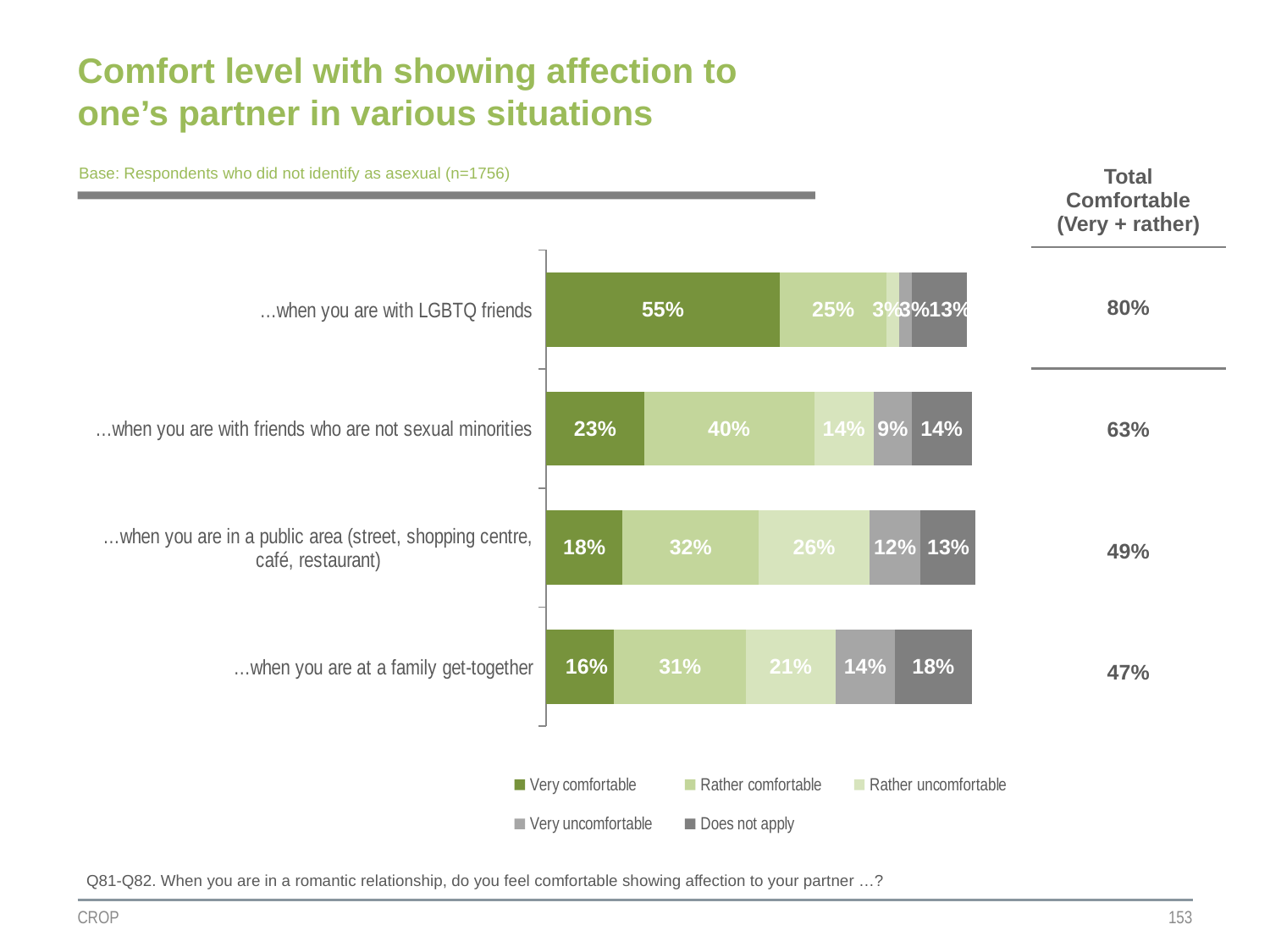
What percentage of respondents are rather uncomfortable showing affection when they are in a public area? 26% Which is larger: the 'Very uncomfortable' share at a family get-together or in a public area? At a family get-together What percentage of respondents answered 'Does not apply' for showing affection at a family get-together? 18% In which situation is the 'Very comfortable' share the highest? …when you are with LGBTQ friends What percentage of respondents are very comfortable showing affection when they are with LGBTQ friends? 55% What kind of chart is shown on the slide? Stacked bar chart How many series does the legend list? 5 What is the difference between the 'Very comfortable' share when with LGBTQ friends and when with friends who are not sexual minorities? 32 percentage points How many situations (categories) are plotted in the chart? 4 Which series is shown in the darkest green colour in the legend? Very comfortable In which situation is the 'Very comfortable' share the lowest? …when you are at a family get-together What percentage of respondents are rather comfortable showing affection when they are with friends who are not sexual minorities? 40%